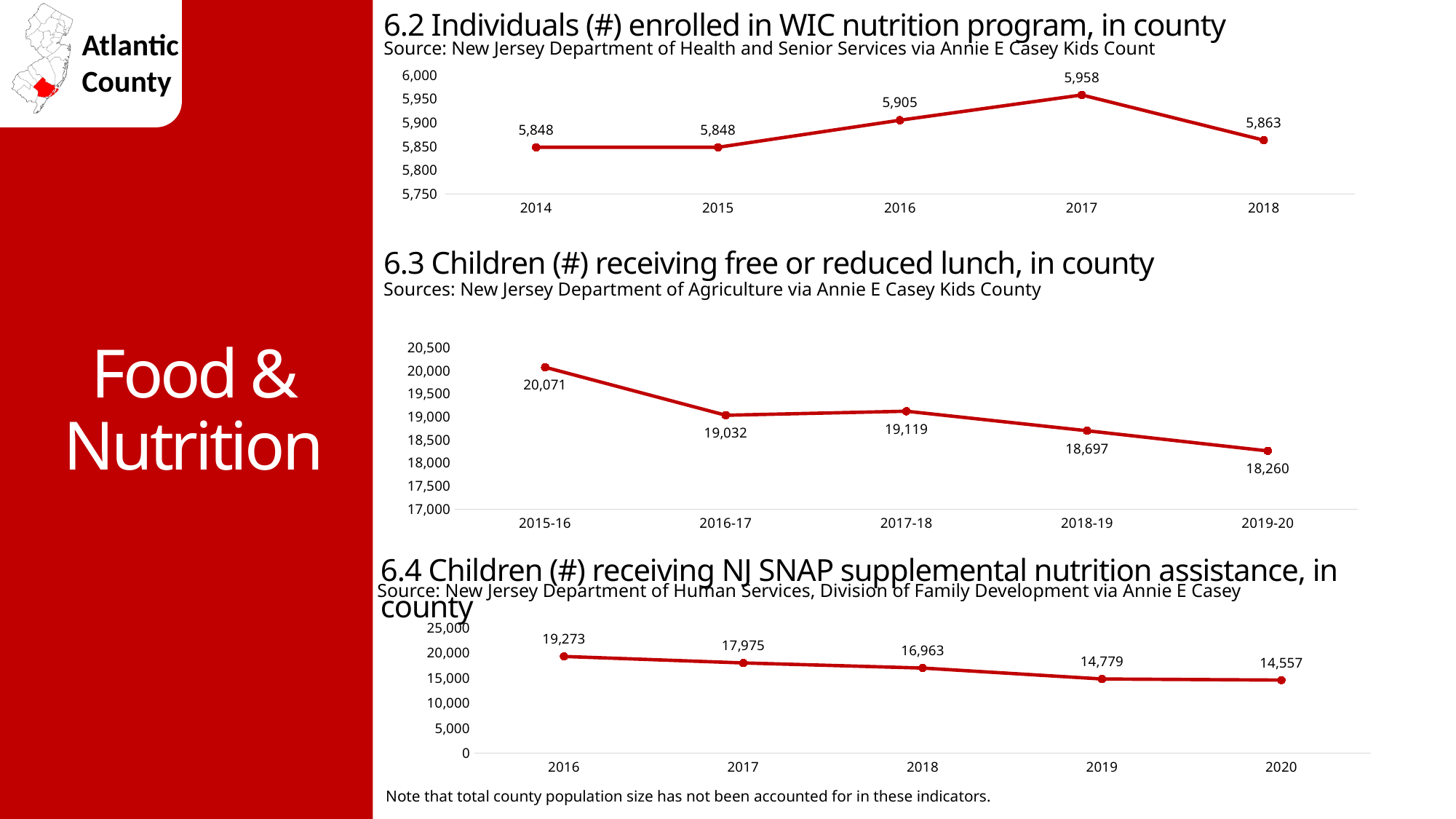
In the chart '6.2 Individuals (#) enrolled in WIC nutrition program, in county', how many data points are plotted? 5 In the chart '6.3 Children (#) receiving free or reduced lunch, in county', what is the difference between the 2015-16 and 2019-20 values? 1,811 In the chart '6.4 Children (#) receiving NJ SNAP supplemental nutrition assistance, in county', is the value for 2016 greater or less than 15,000? greater In the chart '6.3 Children (#) receiving free or reduced lunch, in county', what is the value for 2018-19? 18,697 In the chart '6.2 Individuals (#) enrolled in WIC nutrition program, in county', what is the value for 2017? 5,958 In the chart '6.2 Individuals (#) enrolled in WIC nutrition program, in county', which year has the highest value? 2017 What type of chart is used for '6.4 Children (#) receiving NJ SNAP supplemental nutrition assistance, in county'? line chart In the chart '6.4 Children (#) receiving NJ SNAP supplemental nutrition assistance, in county', what is the value for 2018? 16,963 In the chart '6.3 Children (#) receiving free or reduced lunch, in county', which is larger, the value for 2016-17 or 2017-18? 2017-18 In the chart '6.4 Children (#) receiving NJ SNAP supplemental nutrition assistance, in county', do the values generally rise or fall from 2016 to 2020? fall In the chart '6.3 Children (#) receiving free or reduced lunch, in county', which school year has the lowest value? 2019-20 In the chart '6.2 Individuals (#) enrolled in WIC nutrition program, in county', what is the difference between the 2017 and 2018 values? 95